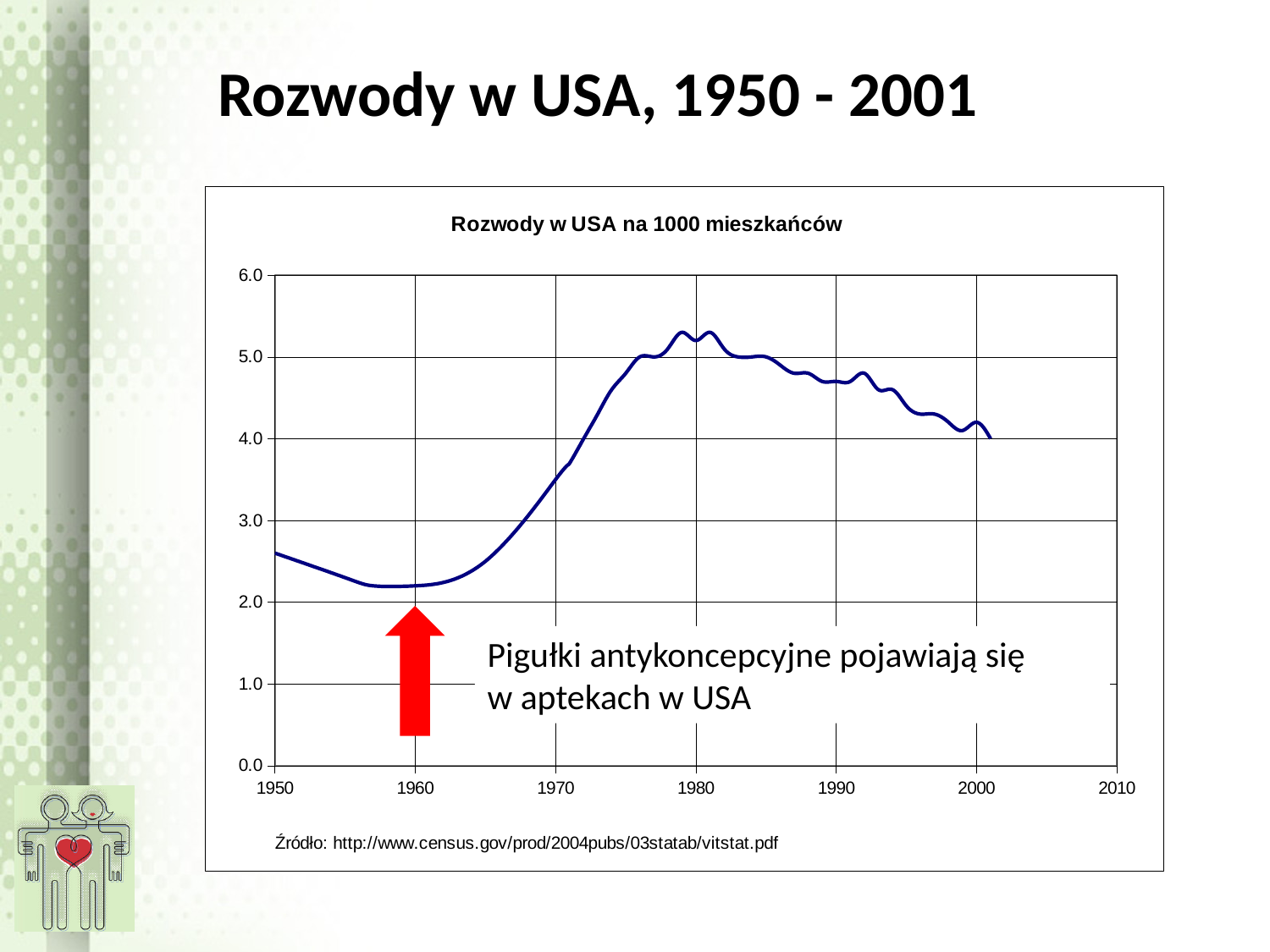
Is the value for 1970 greater or less than 4.0? less Which is larger, the value for 1980 or the value for 1950? 1980 Is the value for 1950 greater or less than 3.0? less What kind of chart is shown on the slide? line chart What is the title of the chart? Rozwody w USA na 1000 mieszkańców Is the value for 1980 greater or less than 5.0? greater Do the values rise or fall between 1980 and 2001? fall Do the values rise or fall between 1960 and 1980? rise